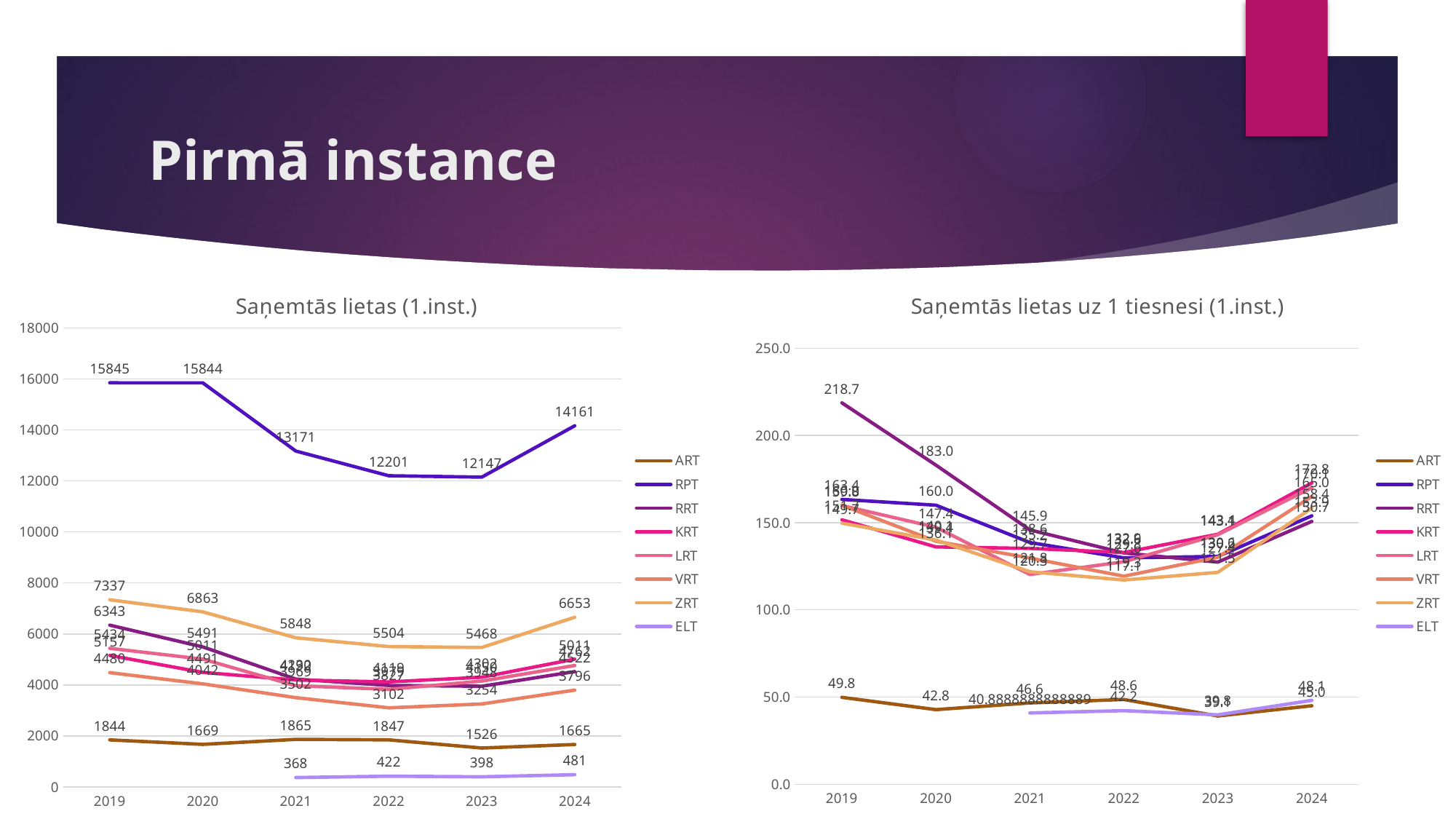
In the left chart "Saņemtās lietas (1.inst.)", what is the value for ART in 2023? 1526 In the left chart "Saņemtās lietas (1.inst.)", what is the value for ELT in 2021? 368 In the left chart "Saņemtās lietas (1.inst.)", does the RPT line rise or fall from 2019 to 2023? fall In the left chart "Saņemtās lietas (1.inst.)", what is the value for ZRT in 2019? 7337 In the right chart "Saņemtās lietas uz 1 tiesnesi (1.inst.)", how many years are shown on the x axis? 6 In the left chart "Saņemtās lietas (1.inst.)", what is the difference between the RPT values for 2019 and 2024? 1684 In the left chart "Saņemtās lietas (1.inst.)", what is the value for RPT in 2019? 15845 What kind of chart is the left chart titled "Saņemtās lietas (1.inst.)"? line chart In the right chart "Saņemtās lietas uz 1 tiesnesi (1.inst.)", what is the value for RRT in 2019? 218.7 In the left chart "Saņemtās lietas (1.inst.)", which series has the highest values across all years? RPT In the left chart "Saņemtās lietas (1.inst.)", what is the value for RPT in 2024? 14161 How many series does the legend of the left chart "Saņemtās lietas (1.inst.)" list? 8